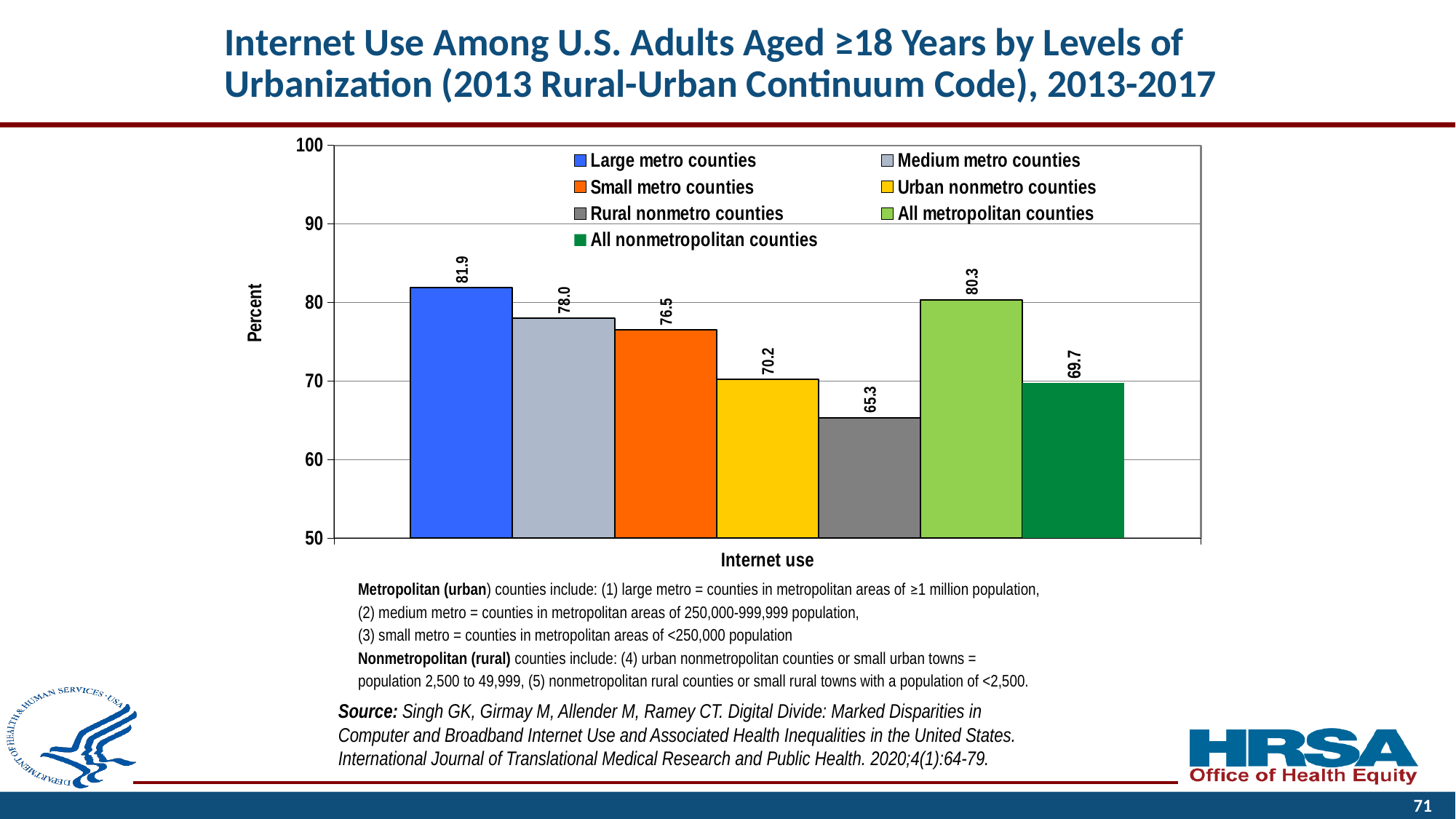
Is the value for Urban nonmetro counties greater or less than 80? less What is the internet use value for Large metro counties? 81.9 How many series does the legend list? 7 What is the difference between the internet use values for All metropolitan counties and All nonmetropolitan counties? 10.6 Which series has the highest internet use value? Large metro counties What is the internet use value for All nonmetropolitan counties? 69.7 What kind of chart is shown on the slide? bar chart Which series has the lowest internet use value? Rural nonmetro counties What is the internet use value for Rural nonmetro counties? 65.3 What is the label of the y axis? Percent Which is larger, the value for Medium metro counties or the value for Small metro counties? Medium metro counties What colour is the bar for Small metro counties? orange